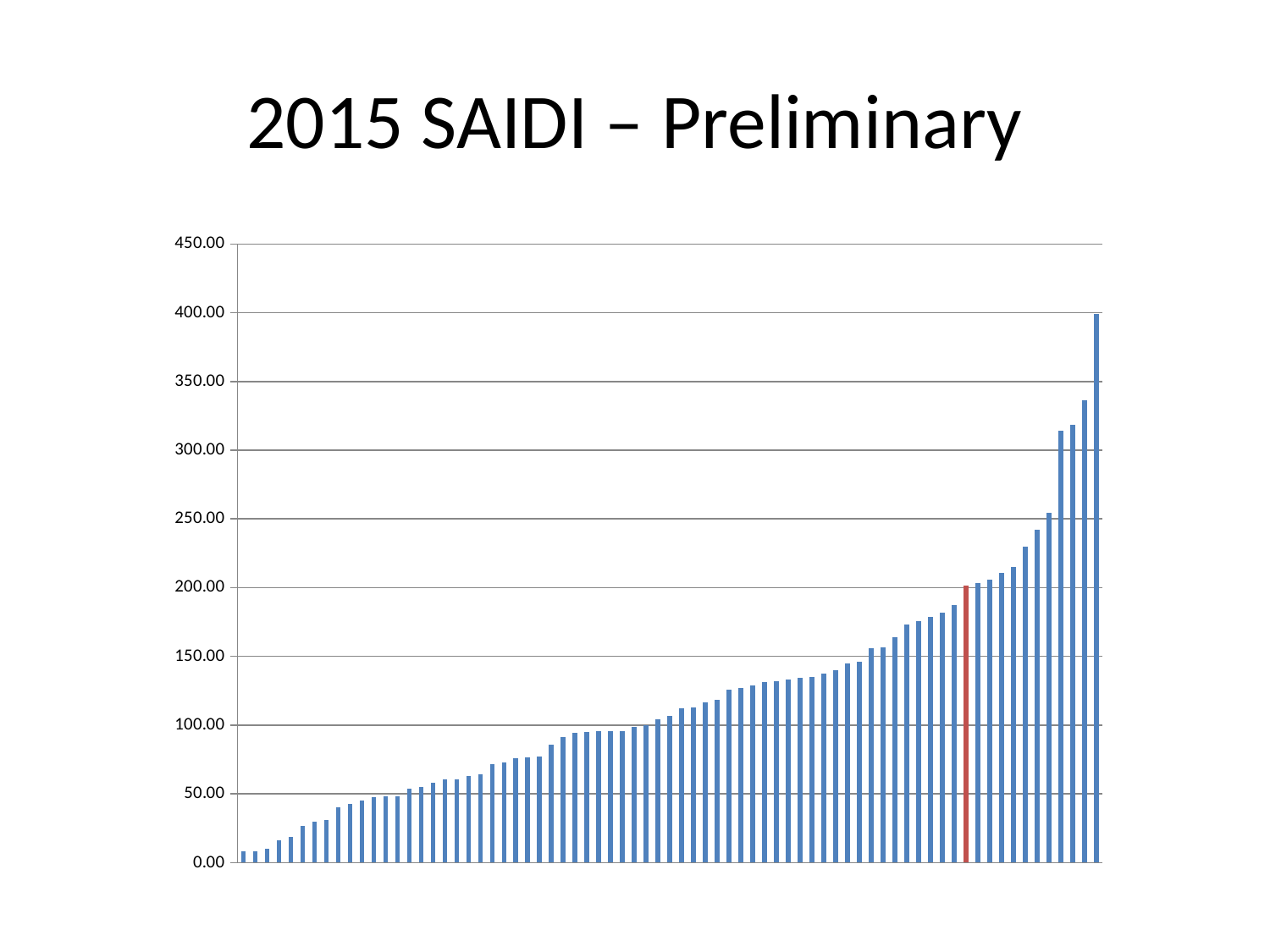
Is the value of the red highlighted bar greater or less than 250.00? less Is the value of the tallest bar (the rightmost bar) greater or less than 350.00? greater Is the value of the leftmost bar greater or less than 50.00? less What is the highest value shown on the y axis? 450.00 What kind of chart is shown on the slide? bar chart Where is the highest bar located on the chart: at the left end or the right end? right end What colour is the single highlighted bar that differs from the others? red Which bar is the highest: the rightmost bar or the red highlighted bar? the rightmost bar Where is the lowest bar located on the chart: at the left end or the right end? left end Do the bar values rise or fall from left to right along the x axis? rise What is the title of the chart on the slide? 2015 SAIDI – Preliminary